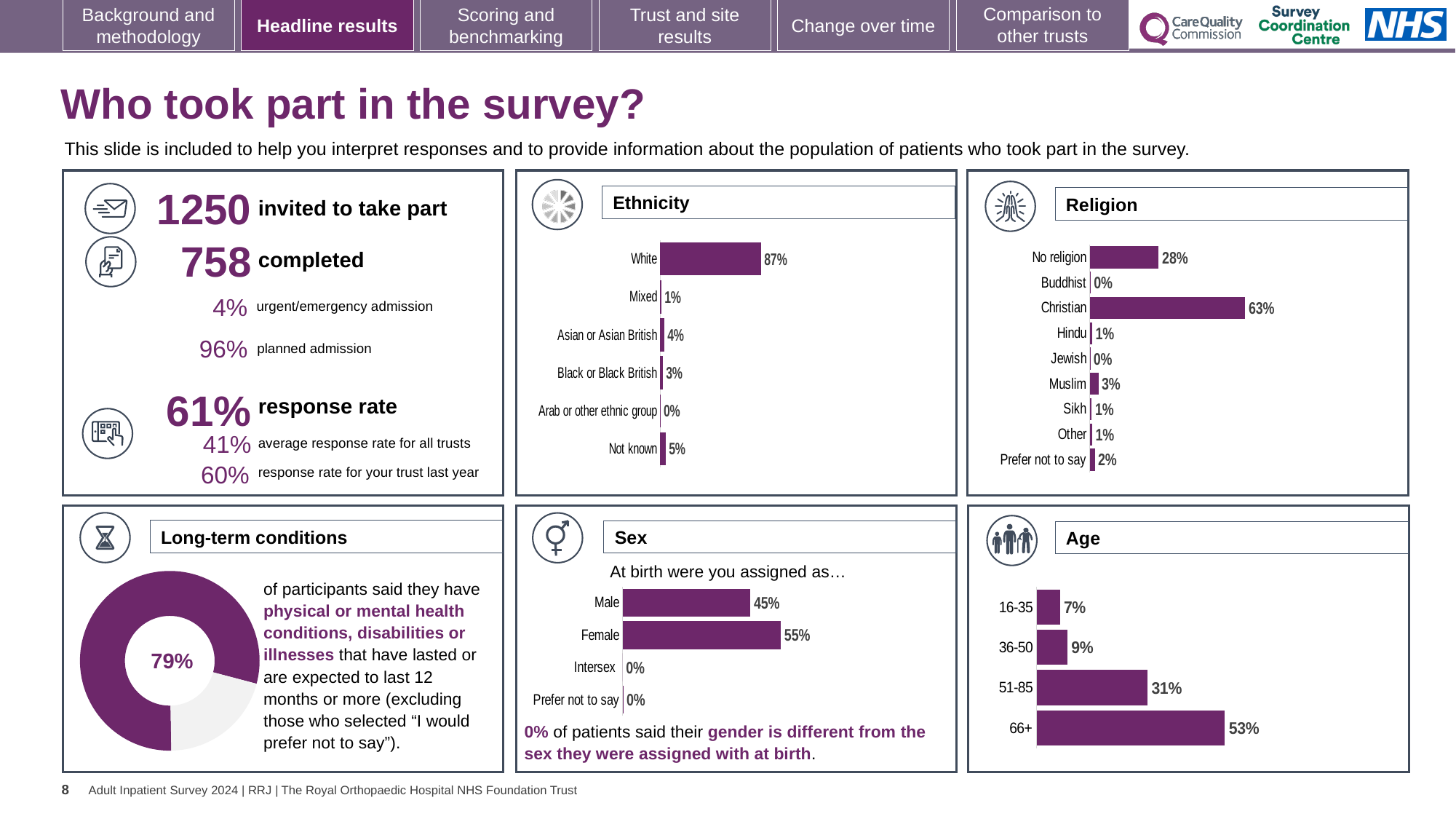
In the Age chart, which age group has the lowest value? 16-35 What kind of chart is the Long-term conditions chart? Doughnut chart In the Religion chart, which category has the highest value? Christian In the Ethnicity chart, what percentage of respondents were White? 87% In the Long-term conditions chart, what share of participants said they have long-term conditions? 79% In the Age chart, what is the difference between the 66+ and 51-85 values? 22% In the Religion chart, what is the value for No religion? 28% In the Ethnicity chart, what is the value for Not known? 5% In the Age chart, do the values rise or fall from 16-35 to 66+? Rise In the Sex chart, which is larger, Male or Female? Female How many categories are shown in the Ethnicity chart? 6 How many categories are shown in the Religion chart? 9